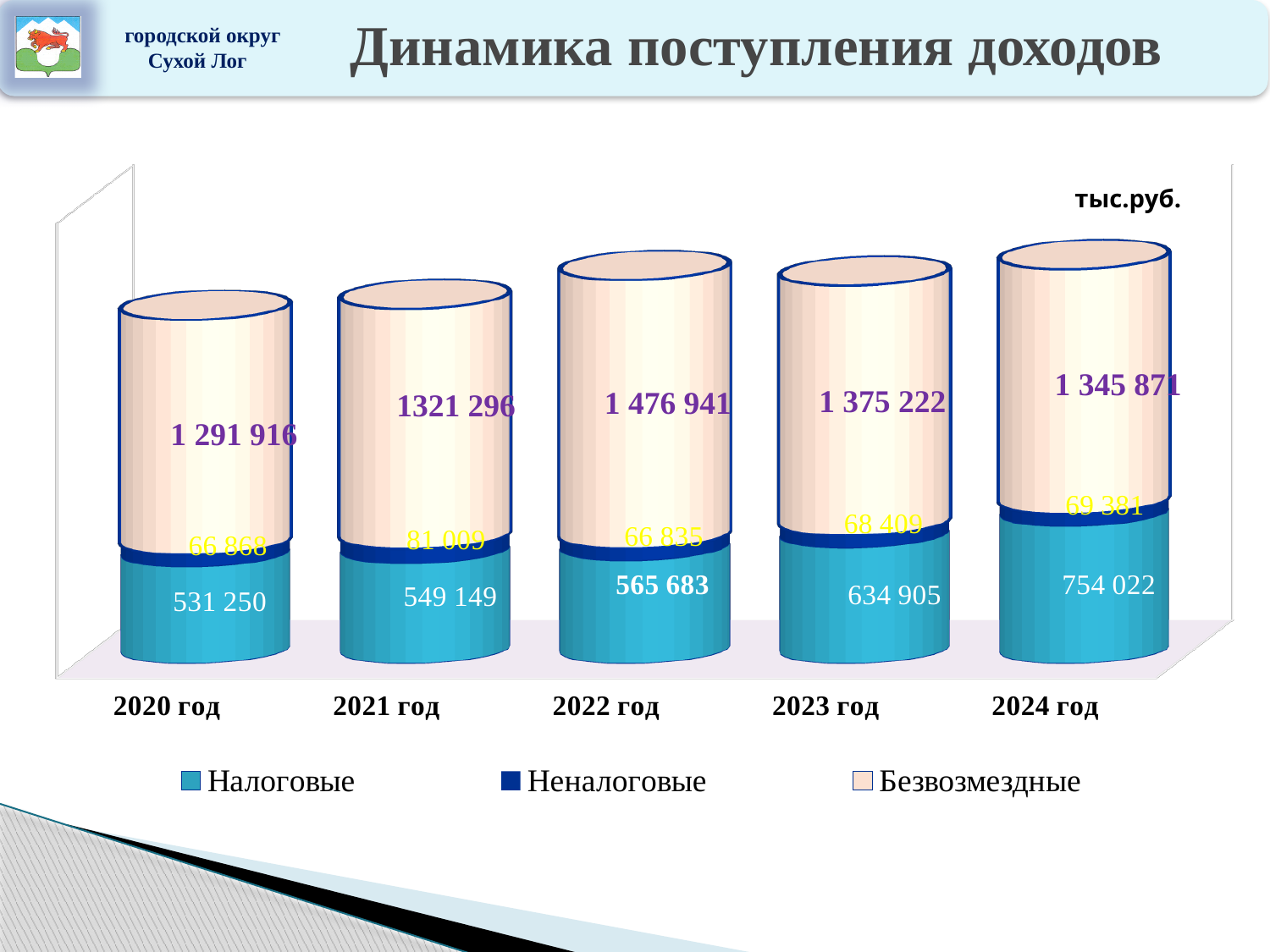
What is the value of Налоговые for 2020 год? 531 250 In which year is the Налоговые value the lowest? 2020 год How many years are shown on the x axis? 5 What is the total of the stacked bar for 2022 год? 2 109 459 What is the value of Безвозмездные for 2022 год? 1 476 941 What kind of chart is shown on the slide? Stacked bar chart Which is larger: the Безвозмездные value for 2023 год or for 2024 год? 2023 год What is the difference between the Налоговые values for 2024 год and 2020 год? 222 772 How many series does the legend list? 3 In which year is the Налоговые value the highest? 2024 год In which year is the Безвозмездные value the highest? 2022 год What is the value of Неналоговые for 2021 год? 81 009